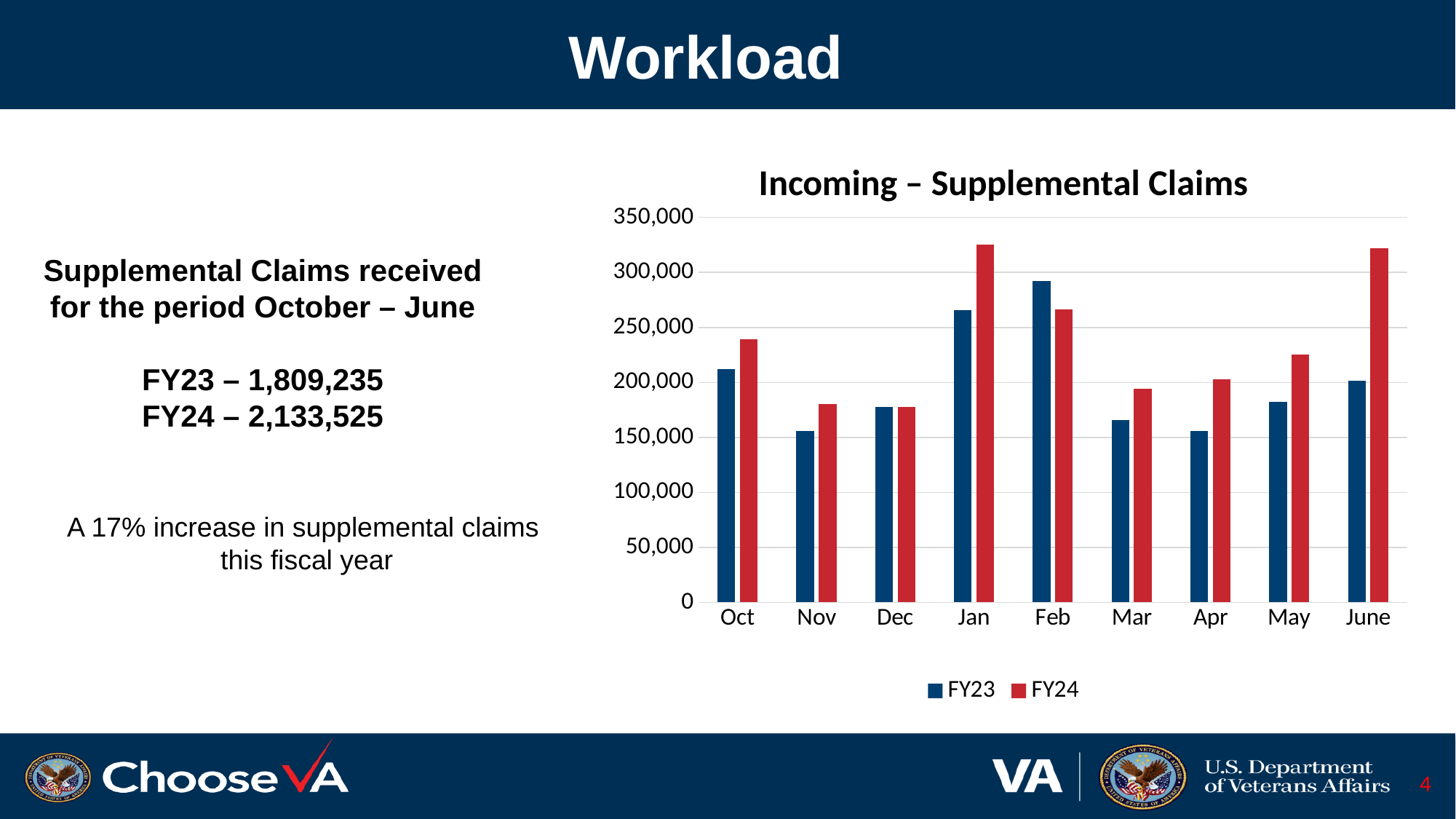
How many months are shown on the x axis of the chart? 9 In Feb, which series has the larger value, FY23 or FY24? FY23 Is the FY23 value for Mar greater or less than 200,000? less What is the title of the chart? Incoming – Supplemental Claims Is the FY24 value for June greater or less than 300,000? greater Is the FY24 value for May greater or less than 200,000? greater How many series does the chart legend list? 2 Which colour represents the FY24 series in the chart? red What kind of chart is shown on the slide? bar chart Which month has the highest FY23 value? Feb